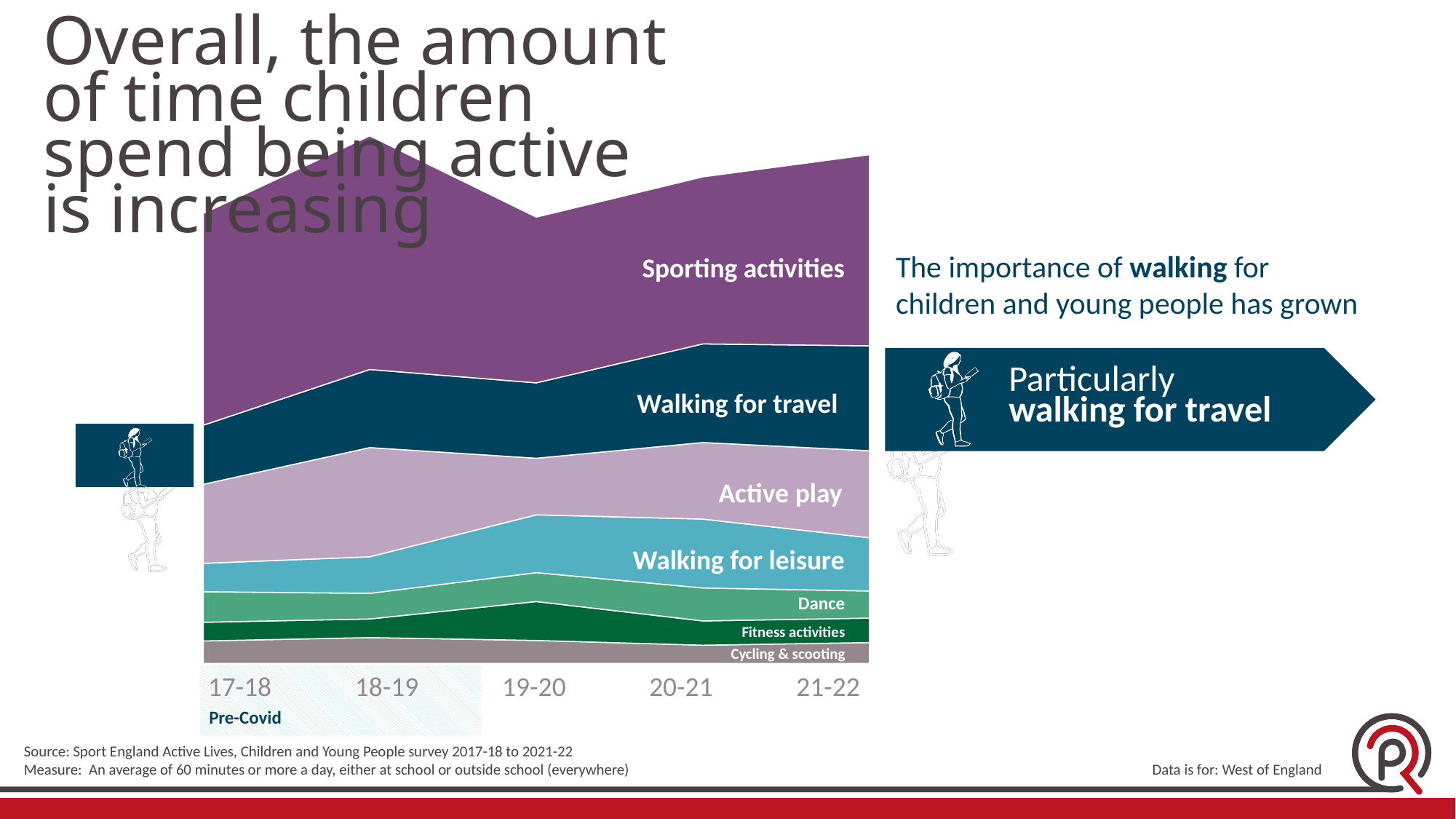
Does the overall height of the stacked area rise or fall between 17-18 and 21-22? Rise In 21-22, which band is larger: Sporting activities or Cycling & scooting? Sporting activities What kind of chart is shown on the slide? Stacked area chart Which activity band sits directly below Sporting activities in the chart? Walking for travel How many activity series are labelled in the chart? 7 Which activity band sits at the very bottom of the stacked area chart? Cycling & scooting Which time periods on the x axis are labelled as Pre-Covid? 17-18 and 18-19 Which activity occupies the smallest band in the chart? Cycling & scooting Which activity occupies the largest band in the chart? Sporting activities How many time periods are shown along the x axis of the chart? 5 In 21-22, which band is larger: Active play or Dance? Active play